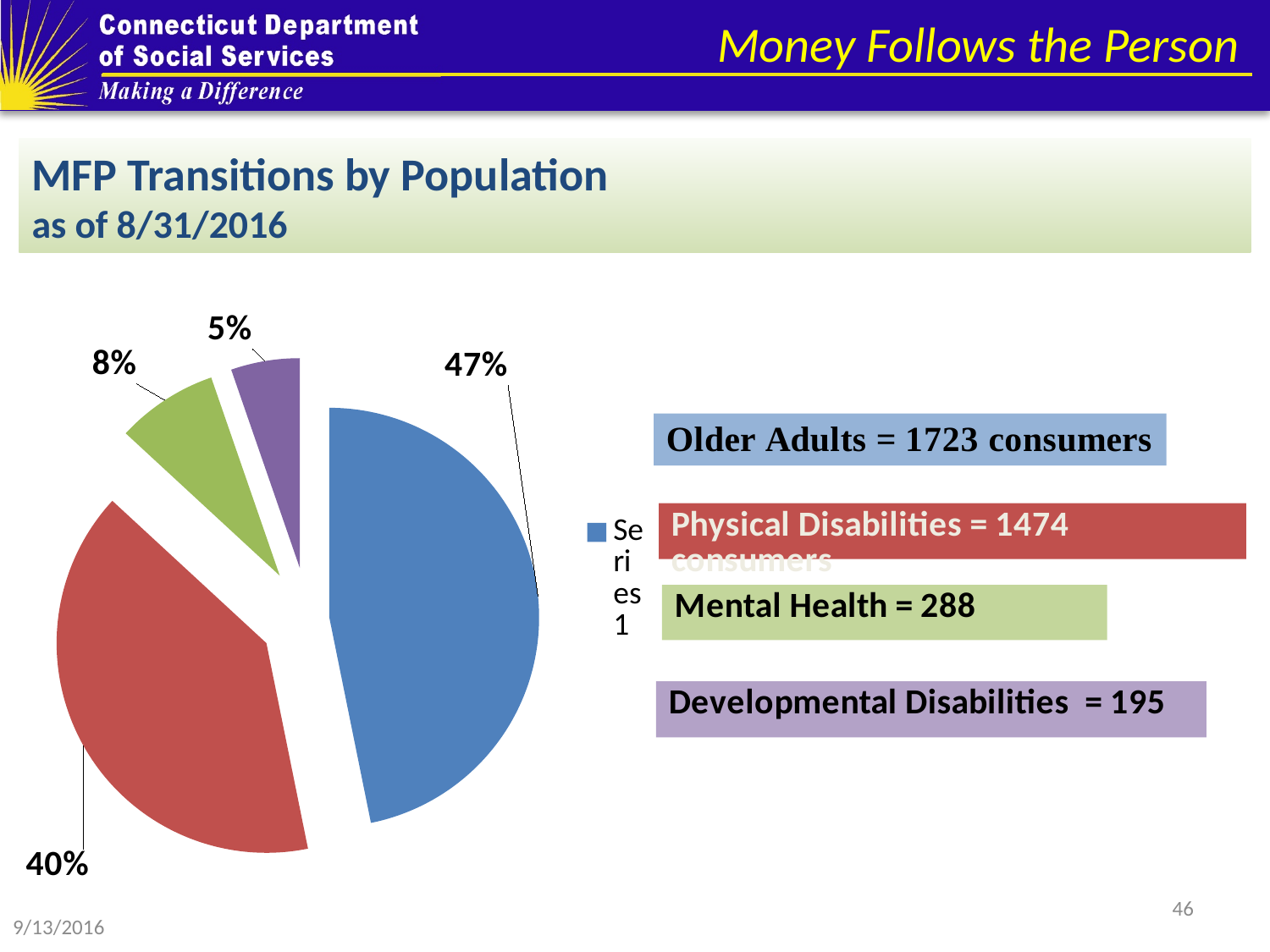
What is the difference in percentage points between the Older Adults slice and the Physical Disabilities slice? 7% What share of the pie does the blue slice (Older Adults) represent? 47% How many consumers are listed for Physical Disabilities on the slide? 1474 How many slices does the pie chart have? 4 Which population has the smallest slice of the pie? Developmental Disabilities What share of the pie does the green slice (Mental Health) represent? 8% What share of the pie does the red slice (Physical Disabilities) represent? 40% What kind of chart is shown on the slide? pie chart Which slice is larger, Mental Health or Developmental Disabilities? Mental Health What is the title of the chart on the slide? MFP Transitions by Population as of 8/31/2016 Which population has the largest slice of the pie? Older Adults